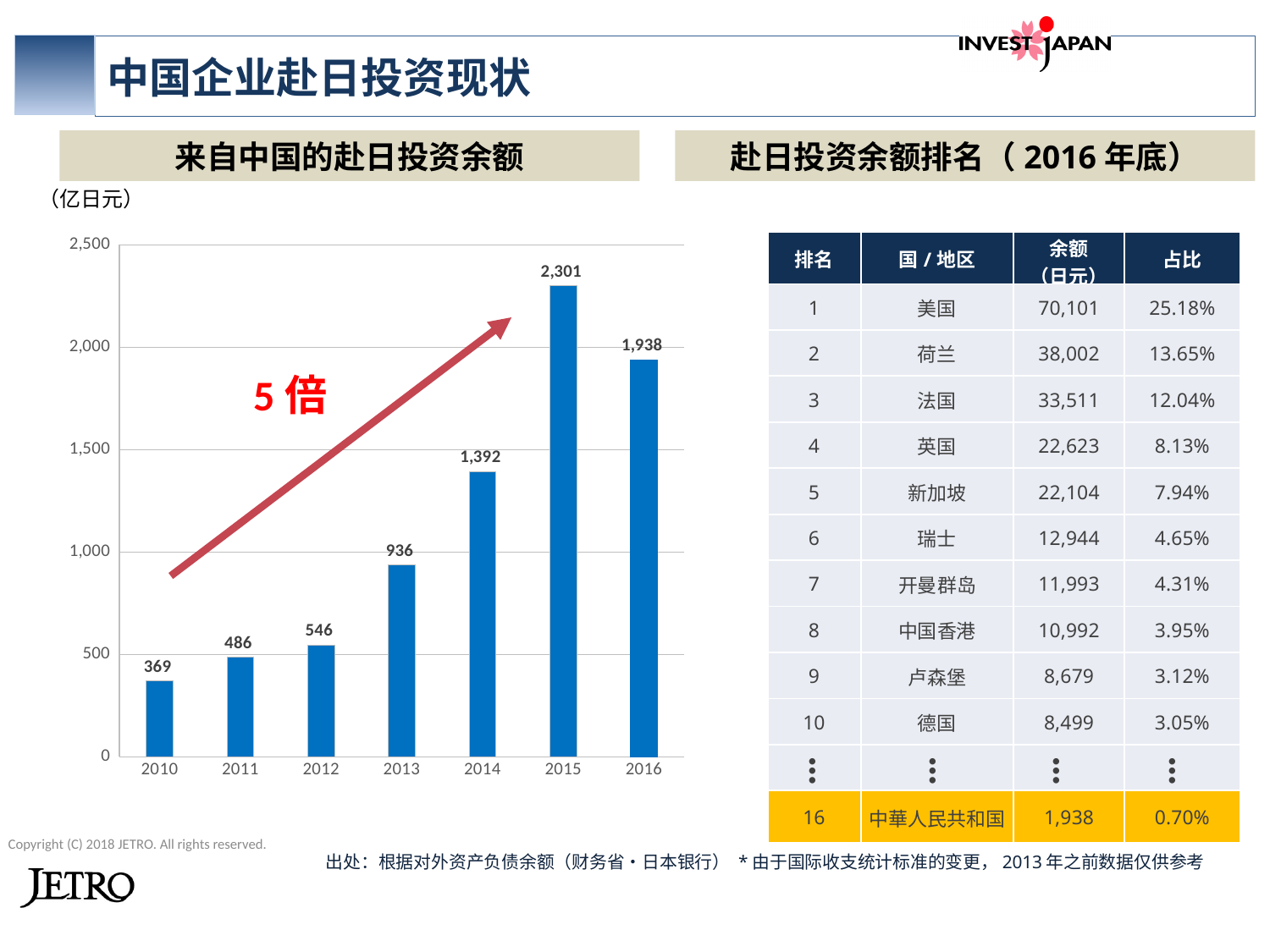
What is the difference between the 2015 and 2016 values in the bar chart? 363 What is the value for 2015 in the bar chart? 2,301 What is the value for 2010 in the bar chart? 369 Which year has the lowest value in the bar chart? 2010 What unit is shown above the bar chart's y axis? 亿日元 Which is larger in the bar chart, the value for 2011 or the value for 2012? 2012 What is the difference between the 2013 and 2012 values in the bar chart? 390 How many years (bars) are shown in the bar chart? 7 What type of chart is shown on the left of the slide? bar chart What is the value for 2014 in the bar chart? 1,392 Do the values in the bar chart generally rise or fall from 2010 to 2015? rise Which year has the highest value in the bar chart? 2015